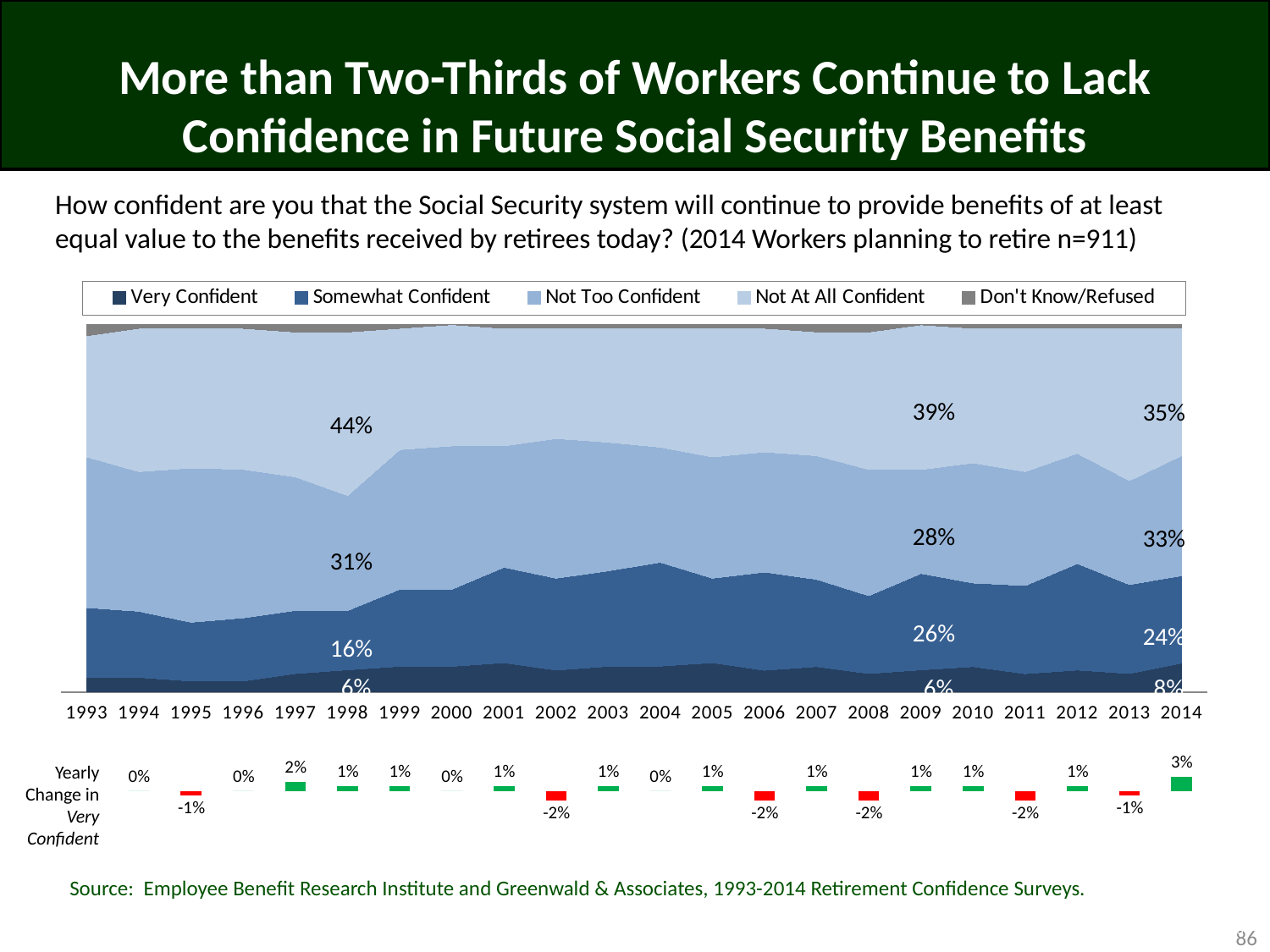
In the main chart, what percentage of workers were Very Confident in 1998? 6% In the main chart, what percentage of workers were Not At All Confident in 2014? 35% In the main chart, by how many percentage points did the Very Confident share change from 2009 to 2014? 2 percentage points In the Yearly Change in Very Confident chart, what is the value for 2002? -2% In the main chart, what percentage of workers were Somewhat Confident in 2009? 26% How many years are shown on the x axis of the main chart? 22 How many series does the legend of the stacked area chart list? 5 In the Yearly Change in Very Confident chart, which year has the highest value? 2014 In the main chart, by how many percentage points did the Not At All Confident share fall from 1998 to 2014? 9 percentage points In the Yearly Change in Very Confident chart, what is the value for 2014? 3% What kind of chart is the main chart showing confidence in Social Security benefits? Stacked area chart In the main chart, which was larger in 2014: Not Too Confident or Somewhat Confident? Not Too Confident